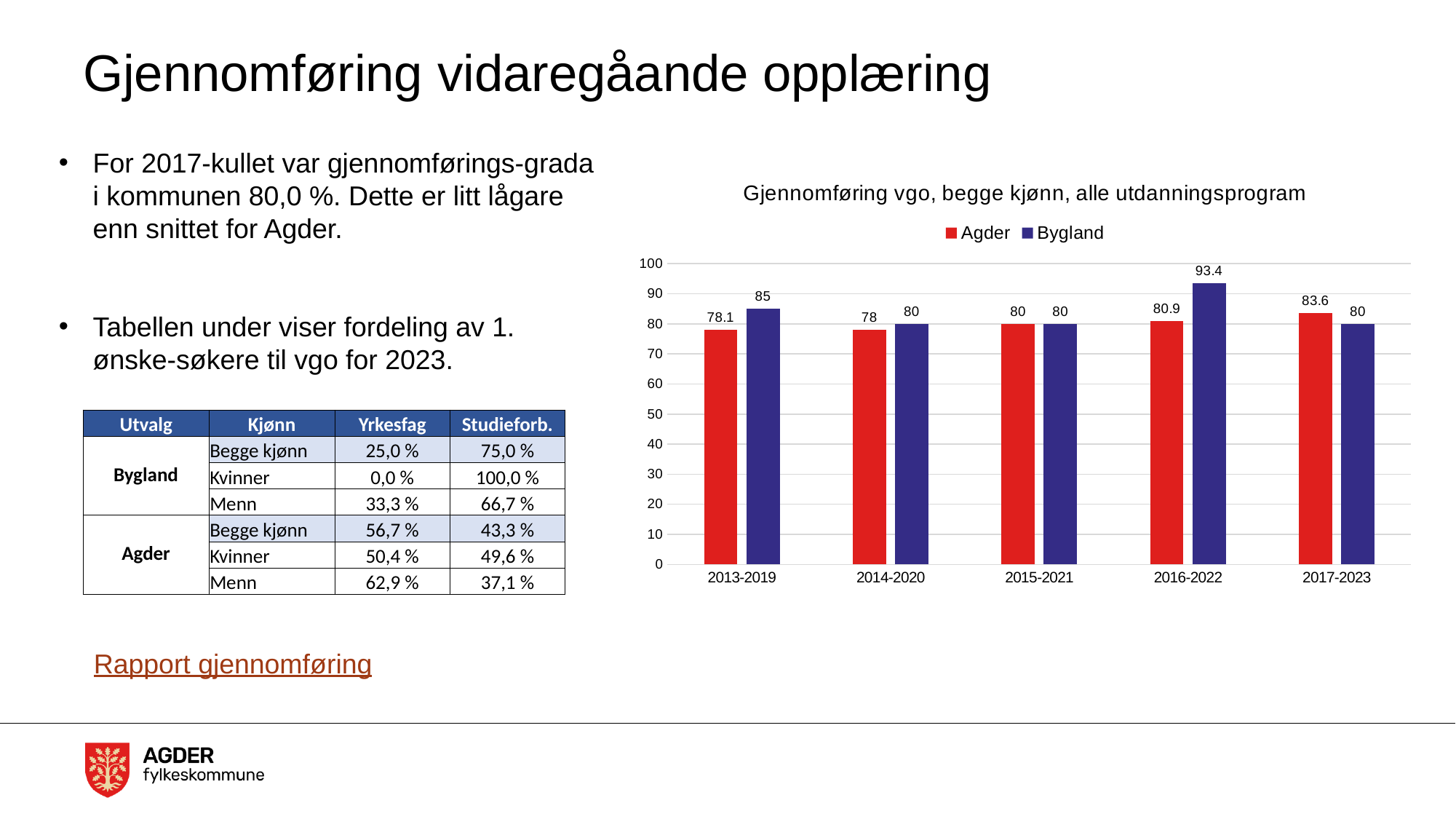
Which period has the highest value for Bygland? 2016-2022 Which is larger in 2017-2023, Agder or Bygland? Agder What kind of chart is shown? bar chart What is the title of the chart? Gjennomføring vgo, begge kjønn, alle utdanningsprogram What is the value for Agder in 2013-2019? 78.1 How many periods are shown on the x axis? 5 What is the value for Bygland in 2016-2022? 93.4 What is the difference between Bygland and Agder in 2016-2022? 12.5 Which period has the lowest value for Agder? 2014-2020 Is the value for Bygland in 2013-2019 greater or less than 90? less What is the value for Agder in 2017-2023? 83.6 How many series does the legend list? 2